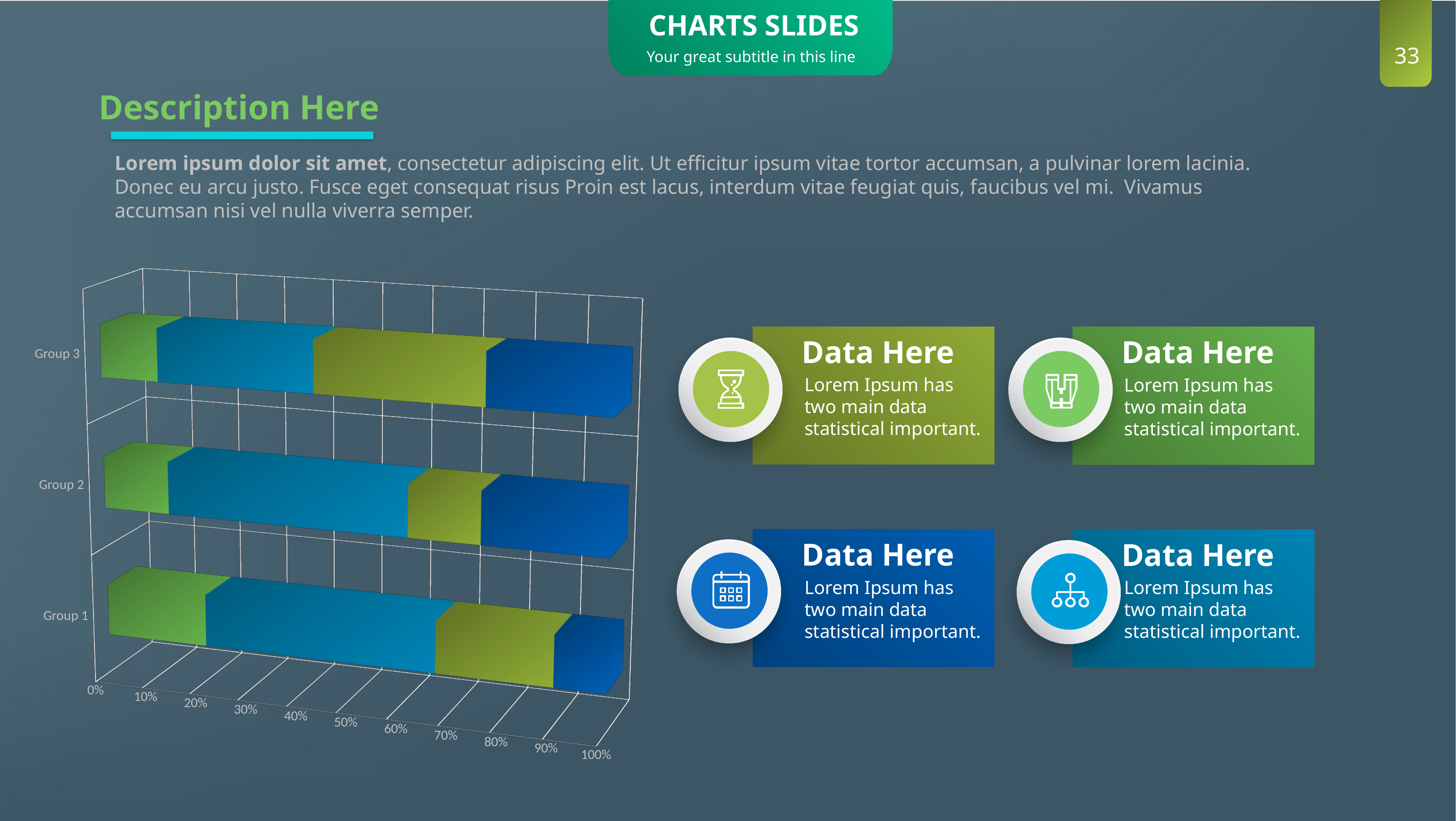
Is the total length of the Group 3 bar greater or less than 80%? greater Is the first (green) segment of the Group 3 bar greater or less than 30%? less What are the category labels on the chart's vertical axis? Group 1, Group 2, Group 3 Is the total length of the Group 1 bar greater or less than 90%? greater Which group is listed at the top of the chart's vertical axis? Group 3 What is the maximum value shown on the chart's percentage axis? 100% How many coloured segments make up each bar in the chart? 4 How many groups (categories) are plotted on the chart? 3 What kind of chart is shown on the left of the slide? bar chart